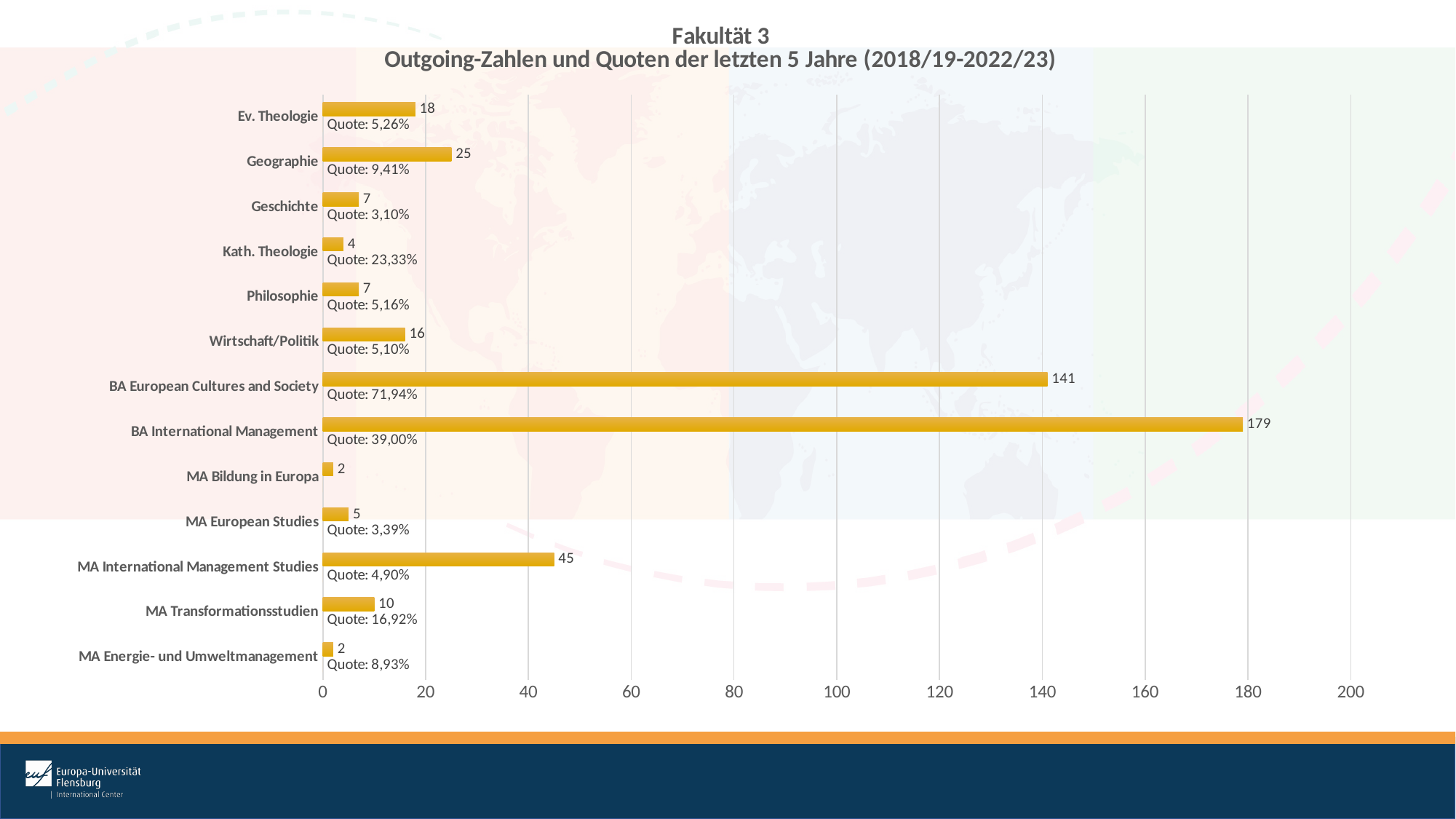
Which is larger, the value for MA International Management Studies or the value for Geographie? MA International Management Studies Which category has the highest value? BA International Management What is the difference between the values for BA International Management and BA European Cultures and Society? 38 Is the value for BA European Cultures and Society greater or less than 120? greater What kind of chart is shown on the slide? bar chart How many categories are shown on the chart? 13 What is the Quote shown for Kath. Theologie? 23,33% What is the Quote shown for BA European Cultures and Society? 71,94% What is the title of the chart? Fakultät 3 Outgoing-Zahlen und Quoten der letzten 5 Jahre (2018/19-2022/23) What is the value for BA International Management? 179 What is the value for MA Transformationsstudien? 10 What is the value for Geographie? 25